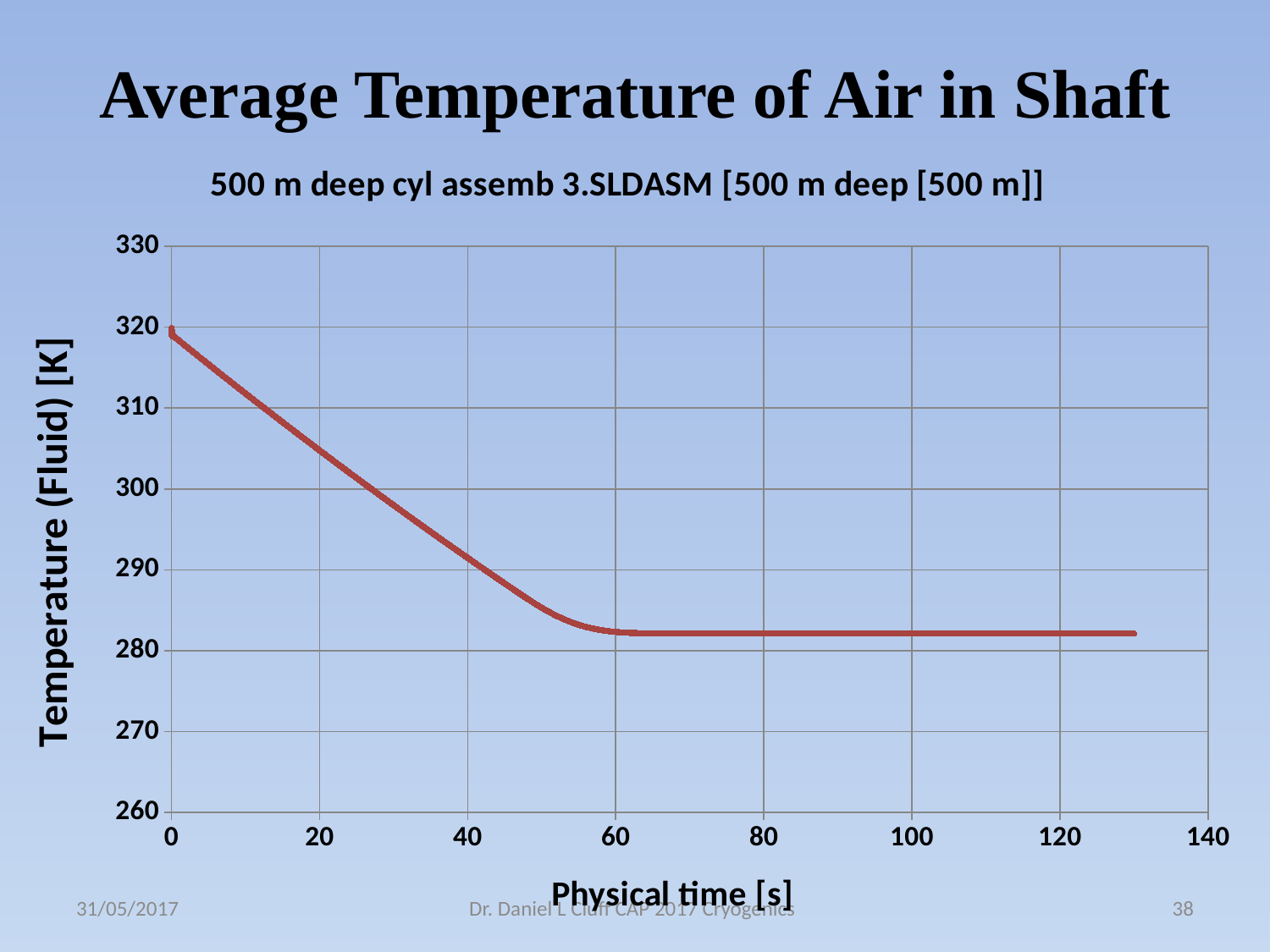
Is the temperature at 0 s greater or less than 310 K? greater Does the temperature rise or fall as physical time increases from 0 s to 60 s? fall What is the label of the x axis? Physical time [s] Is the temperature at 120 s greater or less than 290 K? less Is the temperature at 40 s greater or less than 300 K? less What is the title of the chart? 500 m deep cyl assemb 3.SLDASM [500 m deep [500 m]] How many lines are plotted on the chart? 1 Which is larger, the temperature at 20 s or the temperature at 80 s? 20 s At which physical time is the temperature highest? 0 s What kind of chart is shown on the slide? line chart